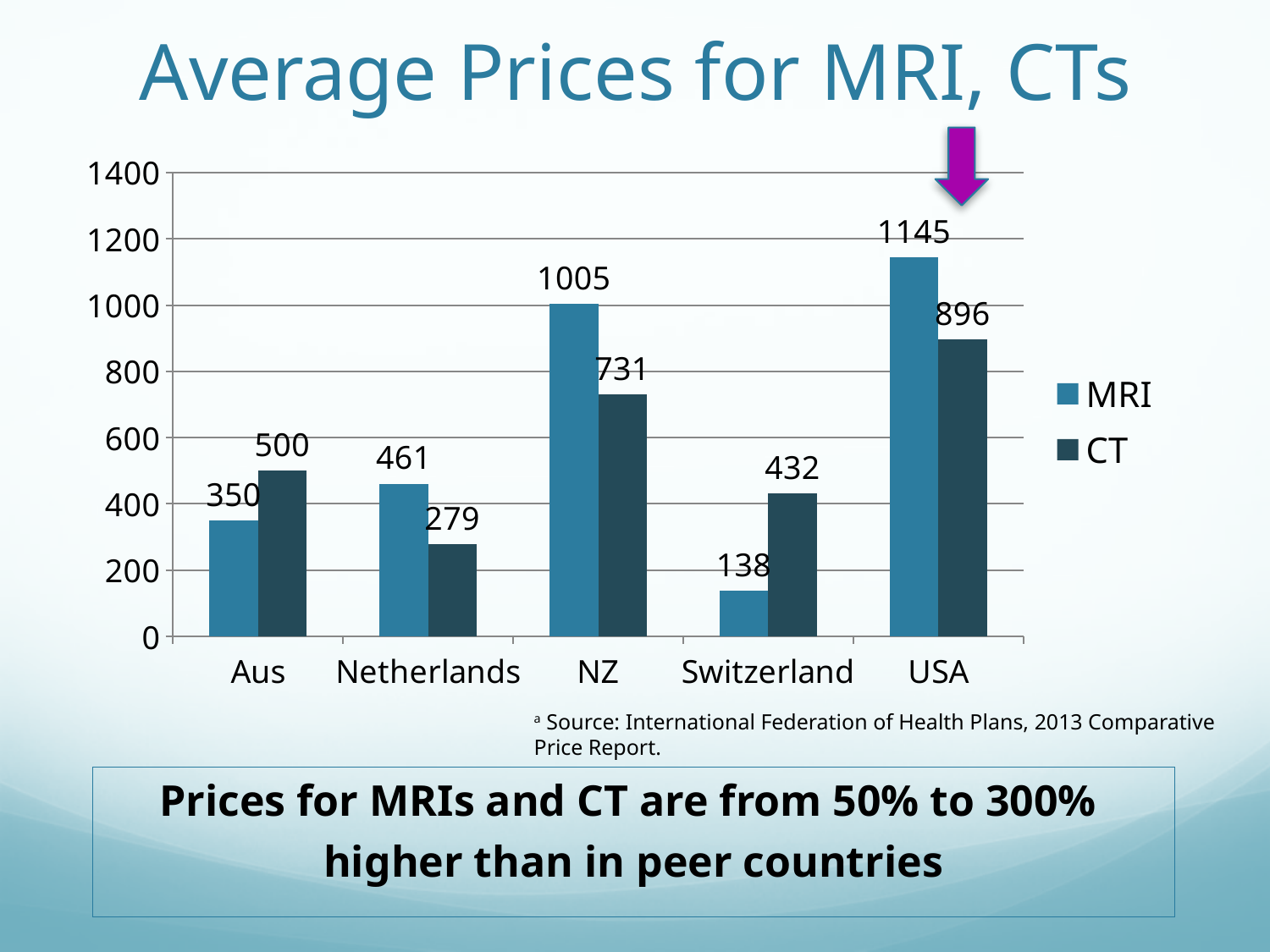
How many series does the legend list? 2 Which country has the lowest MRI price? Switzerland Is the CT value for Switzerland greater or less than 400? greater What is the title of the chart? Average Prices for MRI, CTs What is the MRI price for the USA? 1145 What is the CT price for the Netherlands? 279 Which country has the highest CT price? USA What is the MRI price for Switzerland? 138 What is the difference between the MRI and CT prices for NZ? 274 How many countries are shown on the x axis? 5 What kind of chart is shown on the slide? Bar chart Which is larger for Aus, the MRI price or the CT price? CT